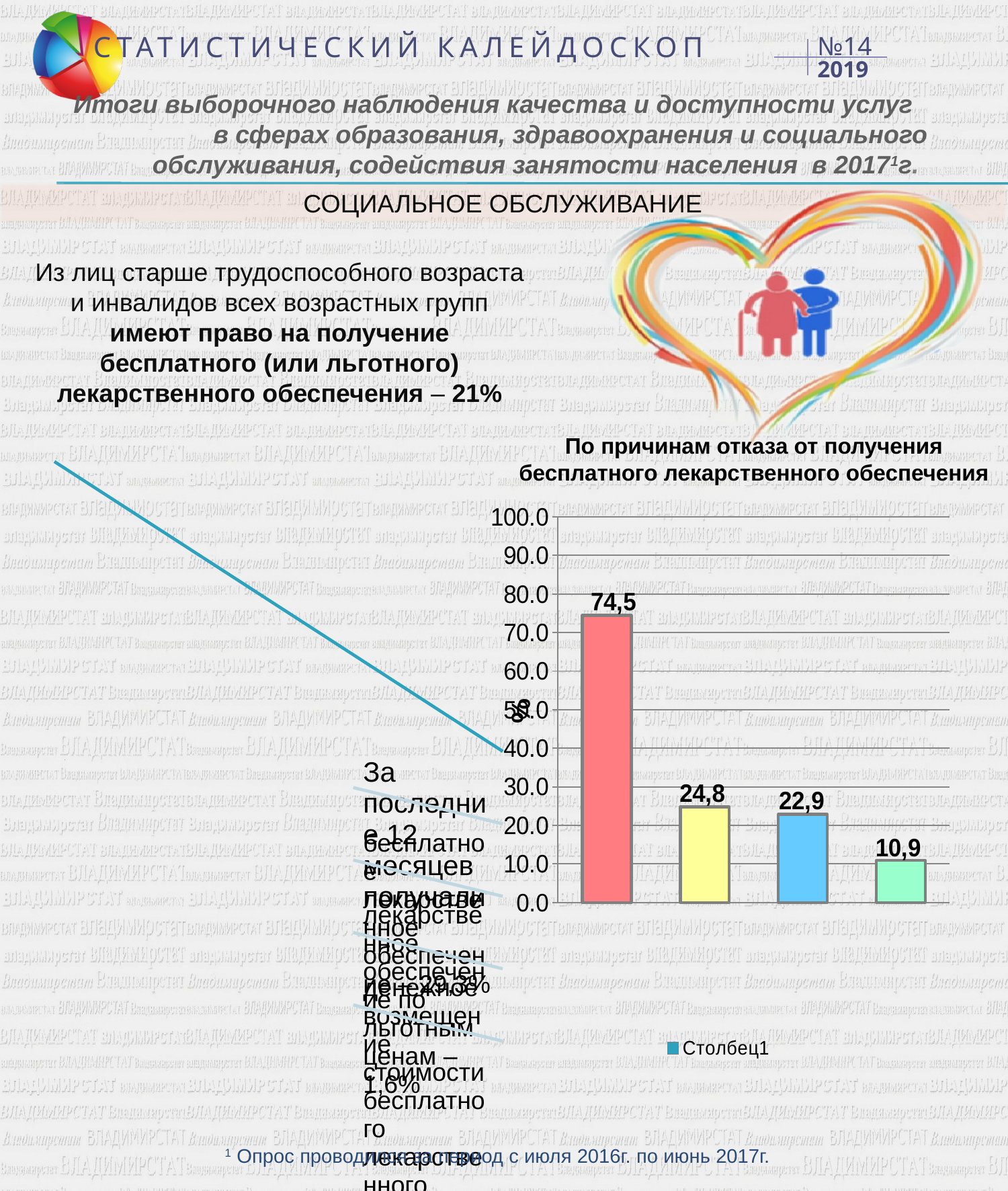
What entry does the legend below the chart list? Столбец1 What is the value labelled on the third (blue) bar of the chart? 22,9 How many bars are plotted in the chart? 4 What is the value labelled on the fourth (rightmost, green) bar of the chart? 10,9 What is the difference between the values of the first bar (74,5) and the second bar (24,8)? 49,7 What is the lowest value shown on the bars in the chart? 10,9 What is the highest value shown on the bars in the chart? 74,5 What type of chart is shown under the title "По причинам отказа от получения бесплатного лекарственного обеспечения"? bar chart Which is larger: the value of the second bar or the value of the third bar? the second bar (24,8) Do the bar values rise or fall from left to right across the chart? fall What is the value labelled on the first (leftmost, red) bar of the chart? 74,5 What is the value labelled on the second (yellow) bar of the chart? 24,8